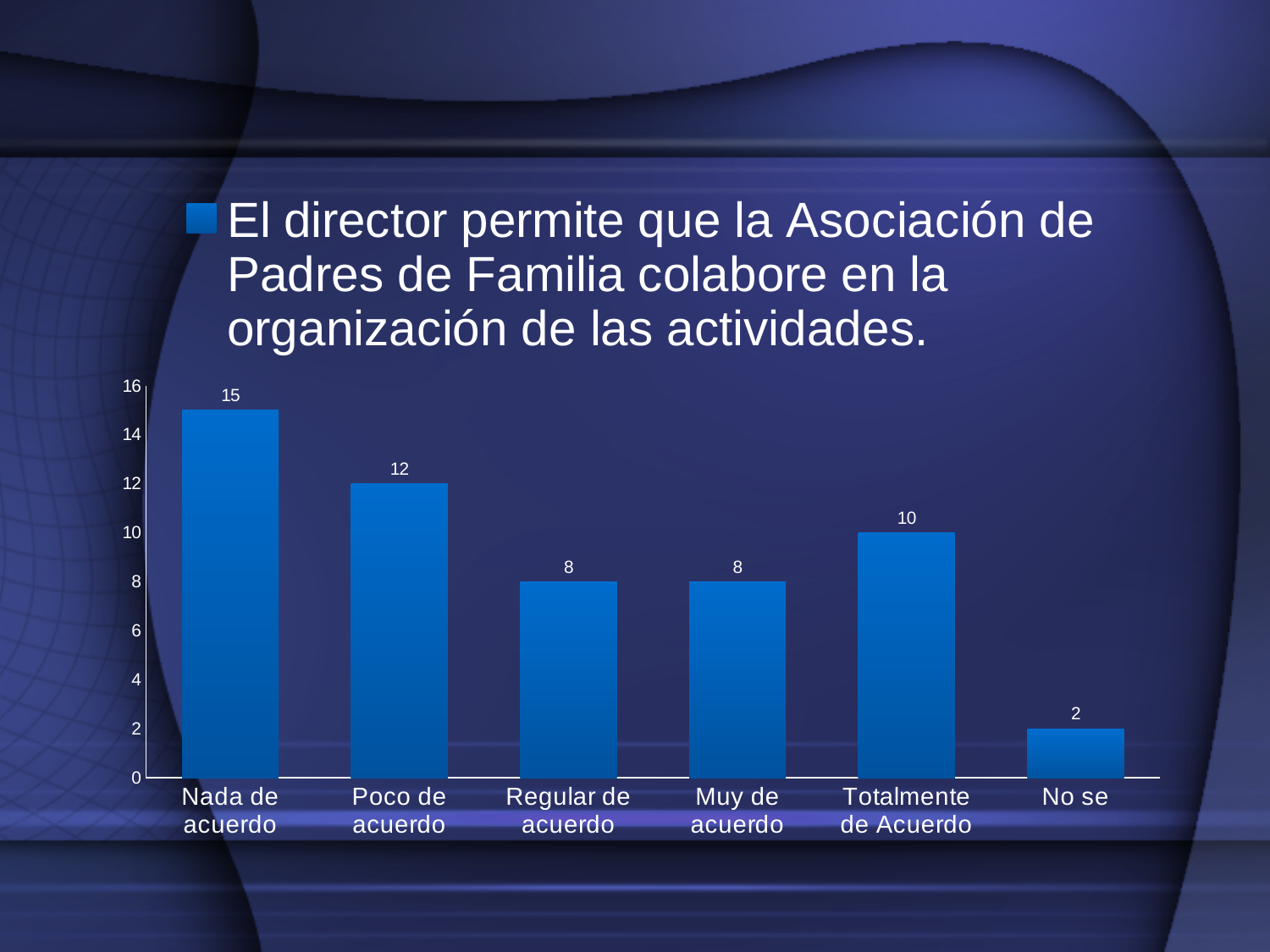
What is the difference between the values for "Nada de acuerdo" and "Poco de acuerdo"? 3 What is the value for "Totalmente de Acuerdo"? 10 Which category has the highest value? Nada de acuerdo How many categories are shown on the x axis? 6 Which category has the lowest value? No se Is the value for "Regular de acuerdo" greater or less than 10? less What is the maximum value shown on the y axis? 16 Which is larger, the value for "Poco de acuerdo" or the value for "Totalmente de Acuerdo"? Poco de acuerdo What is the value for "Nada de acuerdo"? 15 What is the value for "No se"? 2 What is the difference between the values for "Totalmente de Acuerdo" and "No se"? 8 What kind of chart is shown on the slide? bar chart